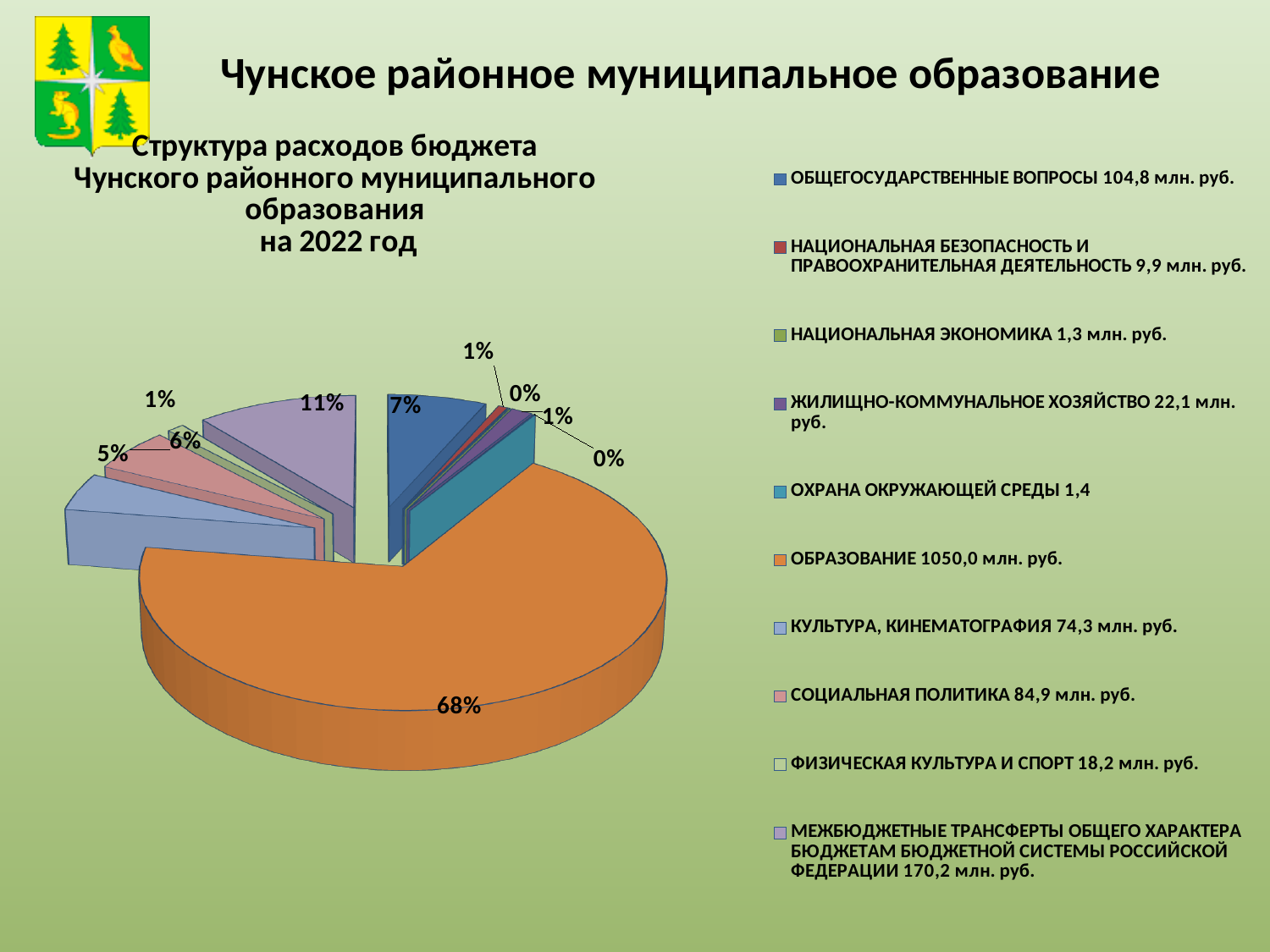
What year does the chart title say the budget expenditure structure refers to? 2022 What share of the pie does МЕЖБЮДЖЕТНЫЕ ТРАНСФЕРТЫ ОБЩЕГО ХАРАКТЕРА БЮДЖЕТАМ БЮДЖЕТНОЙ СИСТЕМЫ РОССИЙСКОЙ ФЕДЕРАЦИИ take? 11% What share of the pie does ОБЩЕГОСУДАРСТВЕННЫЕ ВОПРОСЫ take? 7% What amount in million rubles is shown in the legend for ОБРАЗОВАНИЕ? 1050,0 млн. руб. What amount in million rubles is shown in the legend for СОЦИАЛЬНАЯ ПОЛИТИКА? 84,9 млн. руб. What kind of chart is shown on the slide? Pie chart What amount in million rubles is shown in the legend for КУЛЬТУРА, КИНЕМАТОГРАФИЯ? 74,3 млн. руб. Which is larger according to the legend: НАЦИОНАЛЬНАЯ ЭКОНОМИКА or ОХРАНА ОКРУЖАЮЩЕЙ СРЕДЫ? ОХРАНА ОКРУЖАЮЩЕЙ СРЕДЫ What share of the pie does ОБРАЗОВАНИЕ take? 68% How many categories does the legend of the pie chart list? 10 Which expenditure category is the largest in the pie chart? ОБРАЗОВАНИЕ What is the difference in million rubles between ОБРАЗОВАНИЕ and МЕЖБЮДЖЕТНЫЕ ТРАНСФЕРТЫ ОБЩЕГО ХАРАКТЕРА БЮДЖЕТАМ БЮДЖЕТНОЙ СИСТЕМЫ РОССИЙСКОЙ ФЕДЕРАЦИИ according to the legend? 879,8 млн. руб.